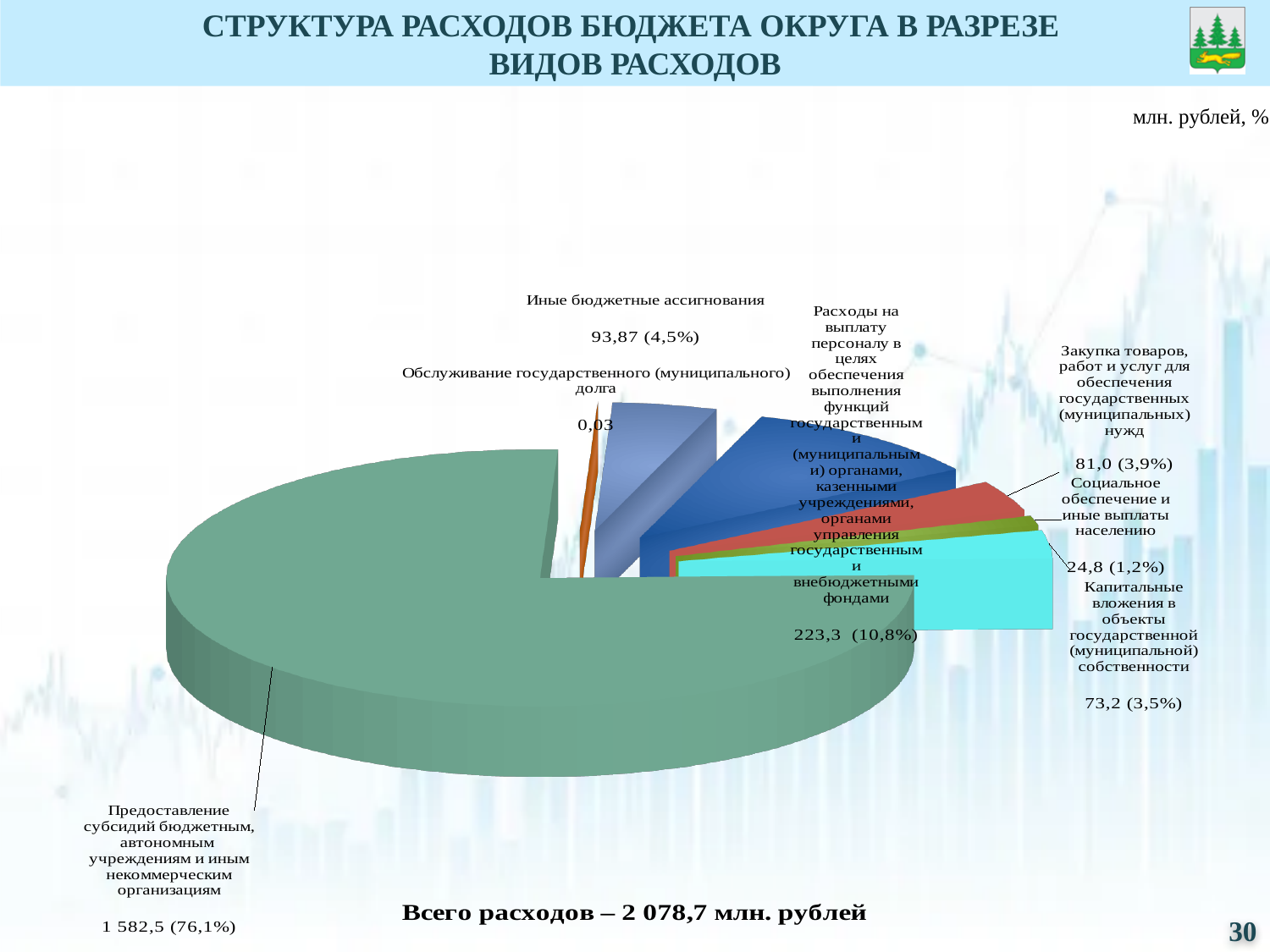
What is the value for "Обслуживание государственного (муниципального) долга"? 0,03 What is the value for "Закупка товаров, работ и услуг для обеспечения государственных (муниципальных) нужд"? 81,0 (3,9%) What is the value for "Социальное обеспечение и иные выплаты населению"? 24,8 (1,2%) What total expenditure is stated below the chart? 2 078,7 млн. рублей What is the value for "Иные бюджетные ассигнования"? 93,87 (4,5%) What kind of chart is shown on the slide? pie chart Which category has the largest share of the pie? Предоставление субсидий бюджетным, автономным учреждениям и иным некоммерческим организациям Which category has the smallest value? Обслуживание государственного (муниципального) долга How many categories (slices) does the pie chart show? 7 What share of the pie does "Расходы на выплату персоналу..." (the blue slice) represent? 10,8% Which is larger: "Иные бюджетные ассигнования" or "Капитальные вложения в объекты государственной (муниципальной) собственности"? Иные бюджетные ассигнования What is the difference in млн. рублей between "Закупка товаров, работ и услуг..." (81,0) and "Капитальные вложения..." (73,2)? 7,8